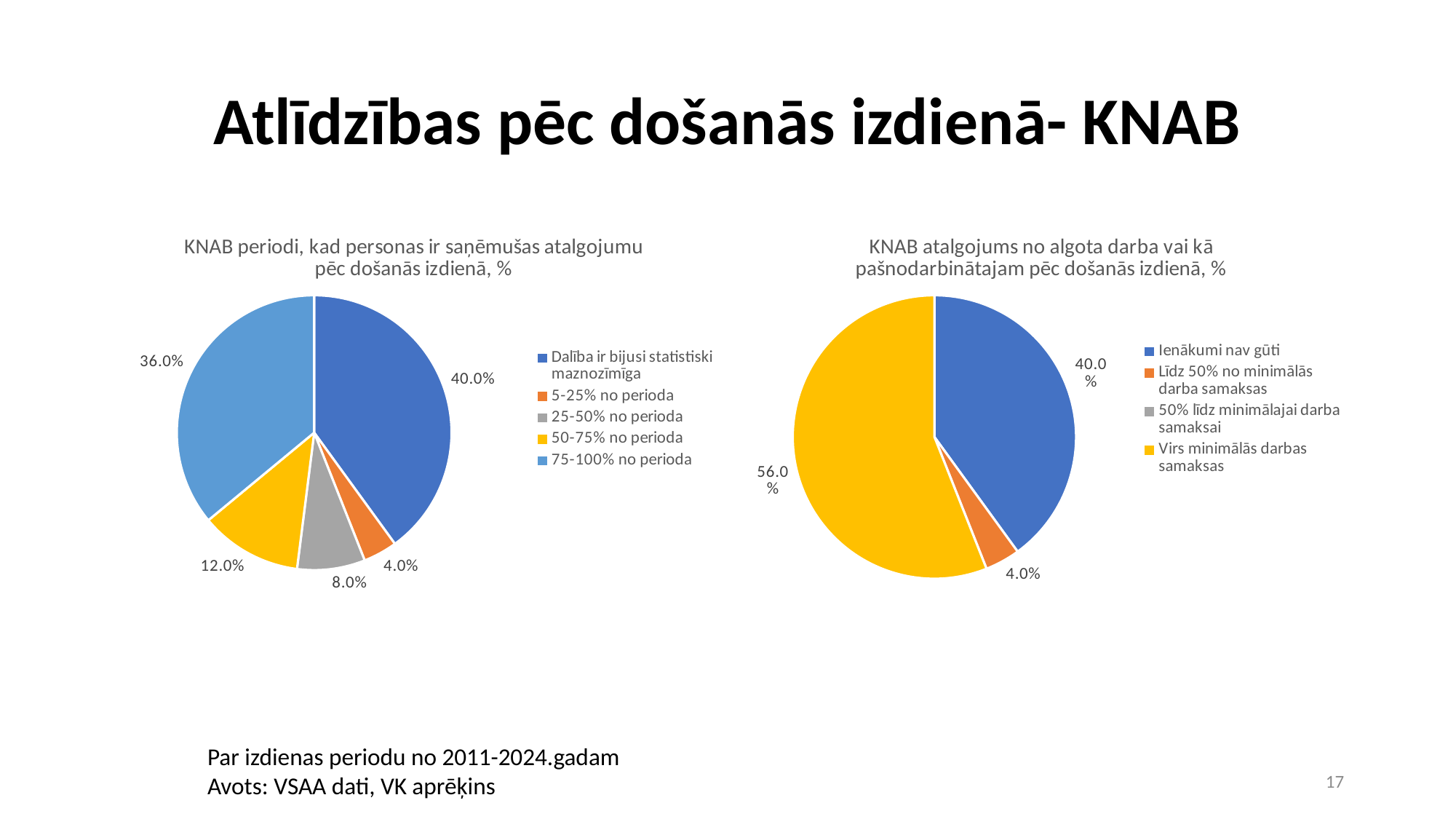
How many categories does the legend of the left chart list? 5 In the left chart, what share is labelled for '75-100% no perioda'? 36.0% What kind of chart is the left chart, 'KNAB periodi, kad personas ir saņēmušas atalgojumu pēc došanās izdienā, %'? Pie chart How many categories does the legend of the right chart list? 4 In the right chart, what share is labelled for 'Ienākumi nav gūti'? 40.0% In the left chart, which category has the largest slice? Dalība ir bijusi statistiski maznozīmīga In the left chart, what is the difference between the shares for '50-75% no perioda' and '25-50% no perioda'? 4.0% In the right chart, what is the difference between the shares for 'Virs minimālās darbas samaksas' and 'Ienākumi nav gūti'? 16.0% In the left chart, which category has the smallest slice? 5-25% no perioda In the right chart, which is larger: 'Ienākumi nav gūti' or 'Virs minimālās darbas samaksas'? Virs minimālās darbas samaksas In the right chart, 'KNAB atalgojums no algota darba vai kā pašnodarbinātajam pēc došanās izdienā, %', what share is labelled for 'Virs minimālās darbas samaksas'? 56.0% In the left chart, what share is labelled for '25-50% no perioda'? 8.0%